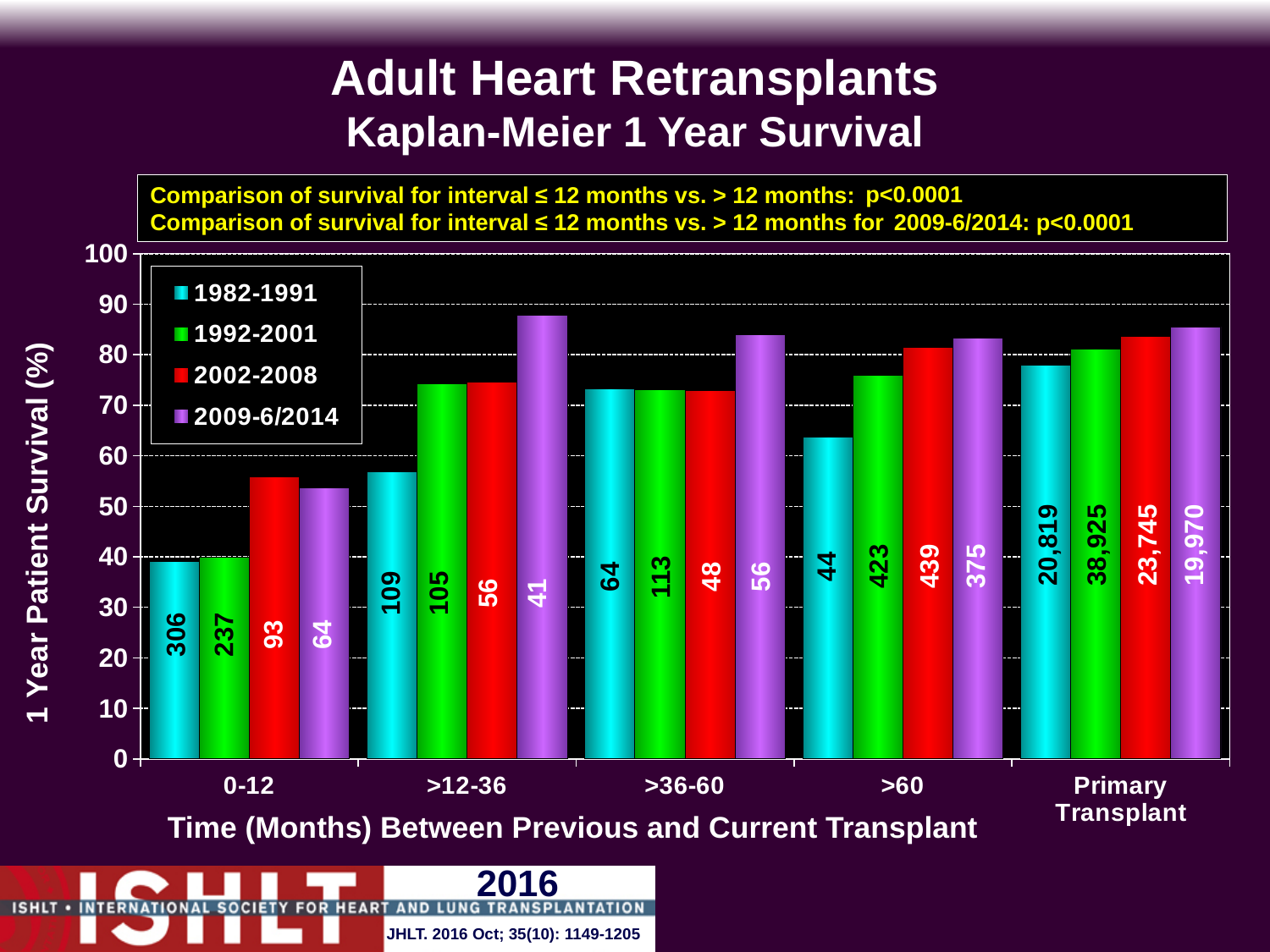
What kind of chart is shown on the slide? bar chart Is the 1 year survival for 2009-6/2014 in the >12-36 month interval greater or less than 80? greater What number is printed on the 1992-2001 bar for Primary Transplant? 38,925 Within the >12-36 month interval, which era has the highest 1 year survival? 2009-6/2014 What number is printed on the 2002-2008 bar for the >60 month interval? 439 Within the >12-36 month interval, which era has the lowest 1 year survival? 1982-1991 For the >36-60 month interval, which is larger: the 1 year survival for 2009-6/2014 or for 2002-2008? 2009-6/2014 How many series does the legend list? 4 How many categories are shown along the x axis? 5 What number is printed on the 2009-6/2014 bar for the >12-36 month interval? 41 Is the 1 year survival for 1982-1991 in the 0-12 month interval greater or less than 50? less What number is printed on the 1982-1991 bar for the 0-12 month interval? 306